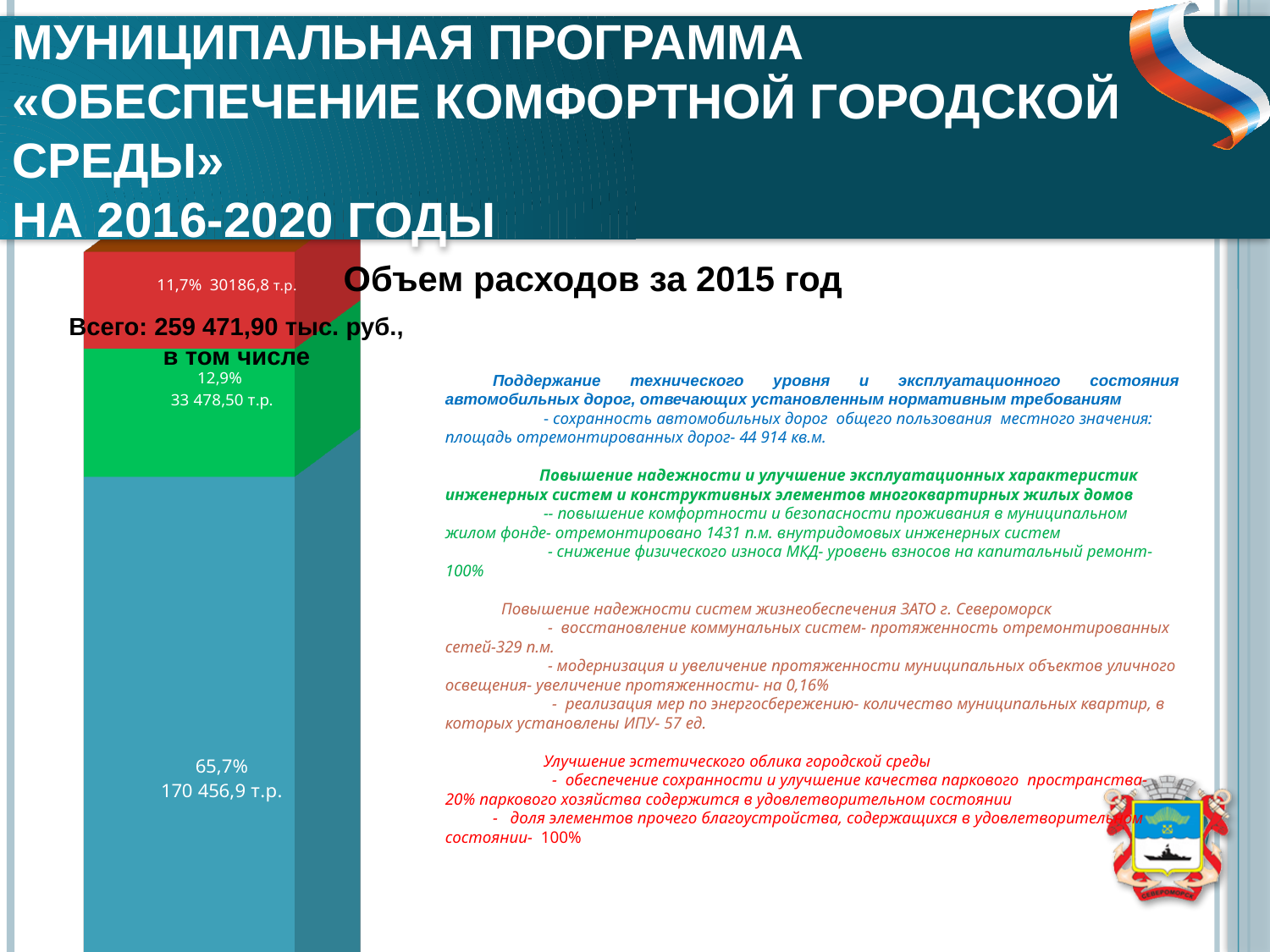
What is the title of the chart on the slide? Объем расходов за 2015 год What amount in т.р. is shown for the red (top) segment of the bar? 30186,8 т.р. What amount in т.р. is shown for the blue (bottom) segment of the bar? 170 456,9 т.р. What is the total of expenditures shown for the stacked bar? 259 471,90 тыс. руб. Which segment of the bar has the largest share? the blue (bottom) segment, 65,7% Which is larger, the green segment's share or the red segment's share? the green segment (12,9%) How many segments make up the stacked bar on the slide? 3 What percentage is shown for the green (middle) segment of the bar? 12,9% What percentage is shown for the blue (bottom) segment of the bar? 65,7% What is the difference in percentage points between the blue segment and the green segment? 52,8 What kind of chart is shown on the left of the slide? stacked bar chart Which segment of the bar has the smallest share? the red (top) segment, 11,7%